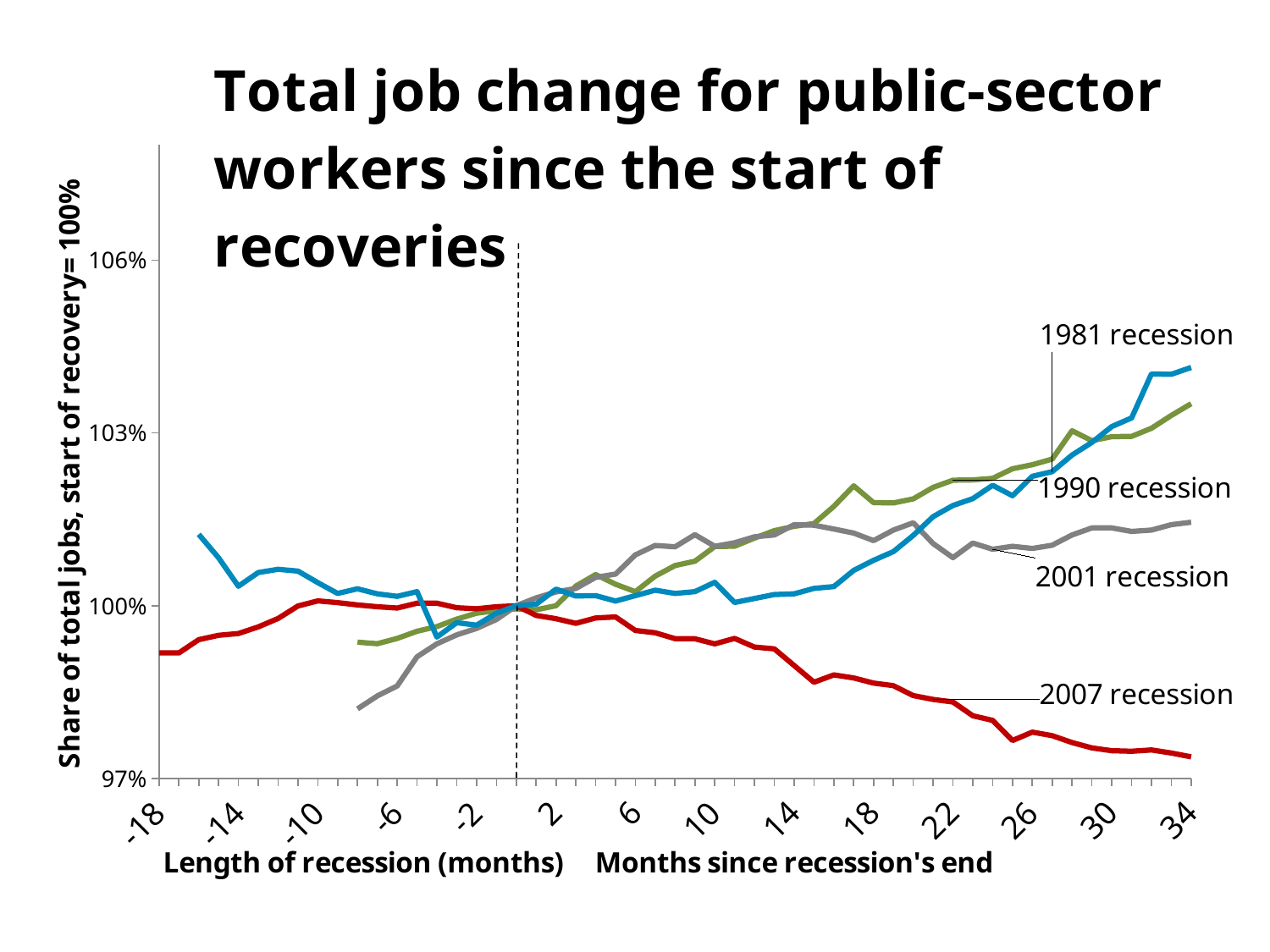
What is the title of the chart? Total job change for public-sector workers since the start of recoveries Is the value for the 1981 recession at month 34 greater or less than 103%? greater Is the value for the 2001 recession at month 34 greater or less than 103%? less Is the value for the 2007 recession at month 34 greater or less than 98%? less How many recession series are plotted on the chart? 4 After month 0, does the 2007 recession line rise or fall as months since the recession's end increase? fall Which recession series is highest at month 34? 1981 recession What is the label of the vertical axis? Share of total jobs, start of recovery= 100% What value do all four series share at month 0, the start of recovery? 100% At month 34, which is larger: the 1981 recession or the 2001 recession? 1981 recession Which recession series is lowest at month 34? 2007 recession What kind of chart is shown on the slide? line chart